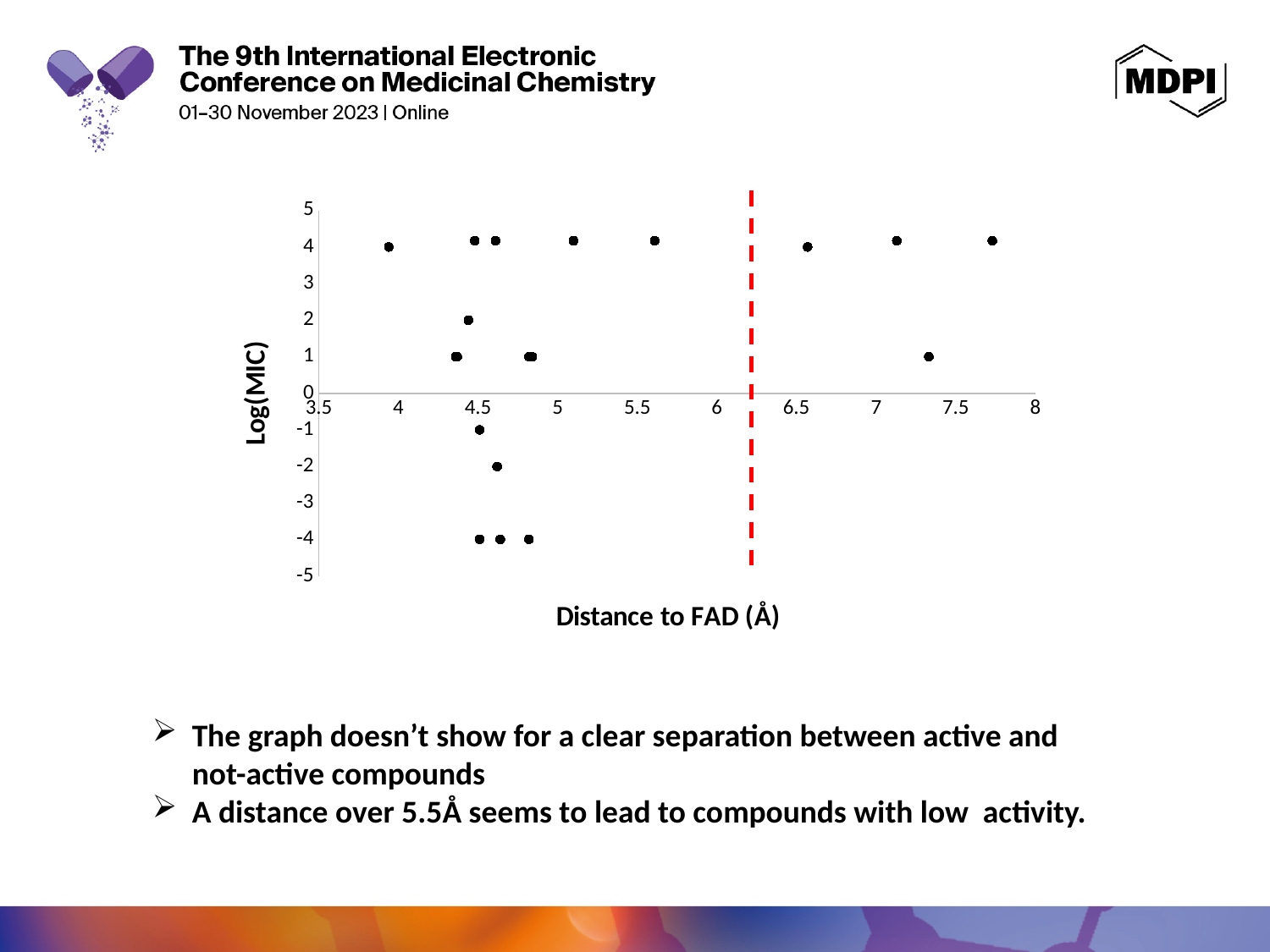
Do all data points with a Distance to FAD greater than 6 have a Log(MIC) greater or less than 0? greater What kind of chart is shown on the slide? scatter plot Is the Distance to FAD of the rightmost data point greater or less than 7.5? greater Is the Distance to FAD of the leftmost data point greater or less than 4? less How many data points lie at Log(MIC) = -4? 3 What is the label of the x axis of the chart? Distance to FAD (Å) How many data points lie to the right of the red dashed line? 4 What is the label of the y axis of the chart? Log(MIC) What is the lowest Log(MIC) value plotted on the chart? -4